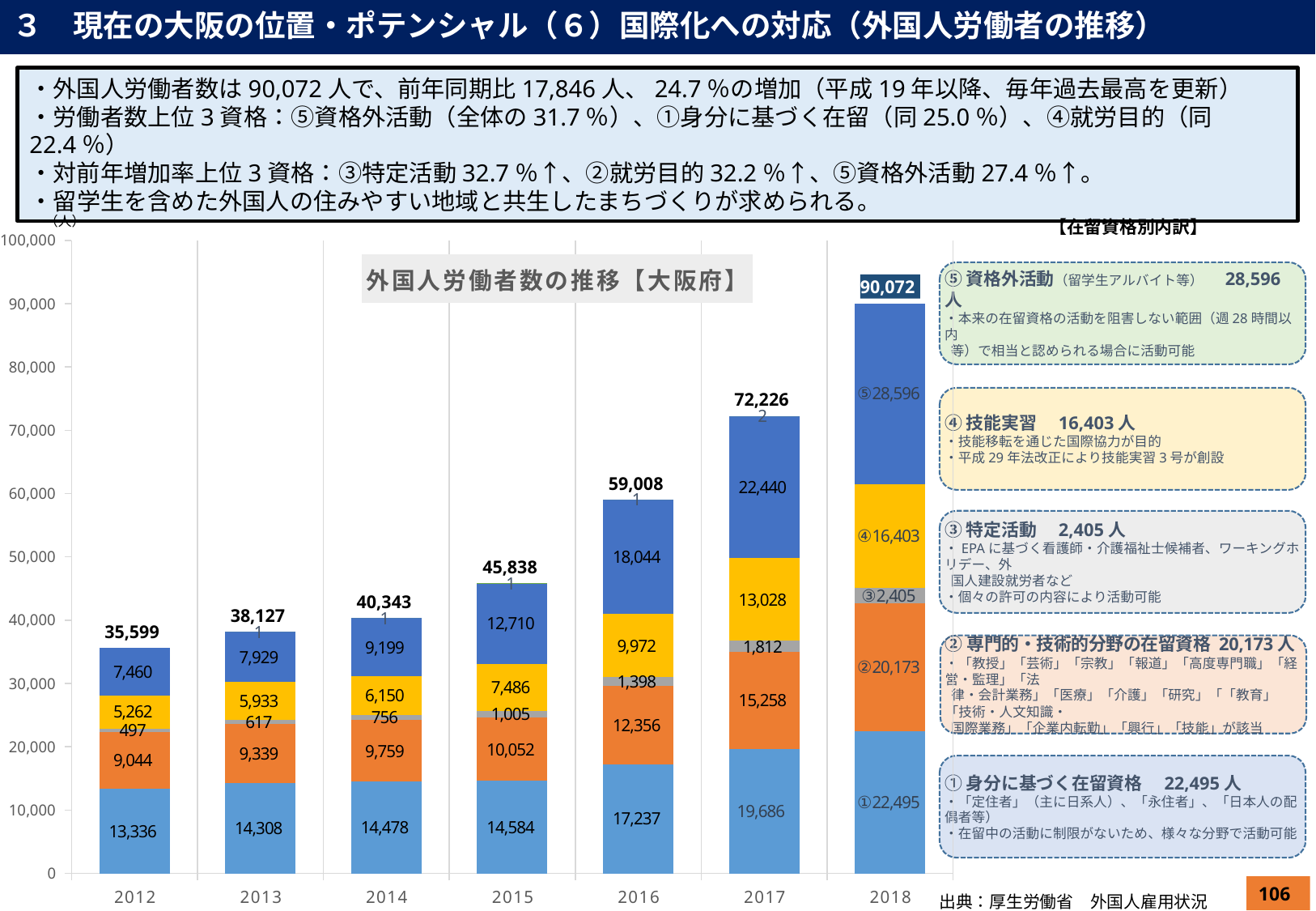
Which is larger, the total for 2016 or the total for 2015? 2016 What is the value of the orange segment in the 2017 bar? 15,258 What kind of chart is used to show the foreign worker numbers? Stacked bar chart Do the total values rise or fall from 2012 to 2018? Rise How many years are shown on the x axis of the chart? 7 What is the value of the yellow segment in the 2015 bar? 7,486 What is the difference between the total for 2018 and the total for 2017? 17,846 What is the total number of foreign workers shown for 2018 in the chart 外国人労働者数の推移【大阪府】? 90,072 Which year has the lowest total number of foreign workers? 2012 Which year has the highest total number of foreign workers? 2018 What is the total value labeled above the 2012 bar? 35,599 What is the value of the bottom (light blue) segment of the 2016 bar? 17,237